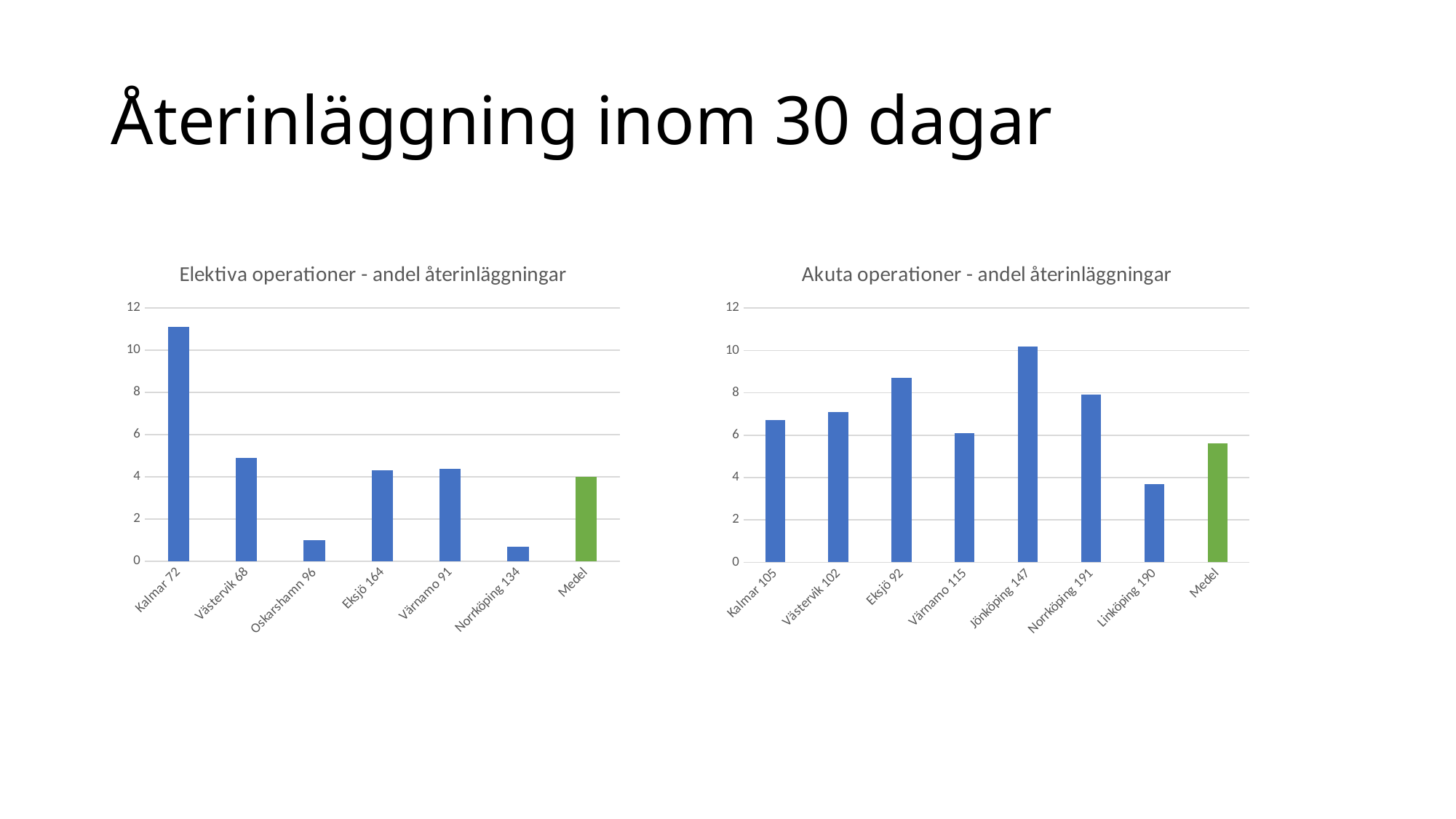
In the chart titled 'Akuta operationer - andel återinläggningar', which category has the lowest bar? Linköping 190 In the chart titled 'Elektiva operationer - andel återinläggningar', which category has the highest bar? Kalmar 72 In the chart titled 'Elektiva operationer - andel återinläggningar', which category has the lowest bar? Norrköping 134 In the chart titled 'Elektiva operationer - andel återinläggningar', which category is shown with a green bar? Medel How many categories are shown in the chart titled 'Elektiva operationer - andel återinläggningar'? 7 In the chart titled 'Elektiva operationer - andel återinläggningar', is the value for Oskarshamn 96 greater or less than 2? less In the chart titled 'Elektiva operationer - andel återinläggningar', is the value for Kalmar 72 greater or less than 10? greater In the chart titled 'Akuta operationer - andel återinläggningar', which category has the highest bar? Jönköping 147 What type of chart is the chart titled 'Akuta operationer - andel återinläggningar'? Bar chart In the chart titled 'Akuta operationer - andel återinläggningar', which is larger, the value for Norrköping 191 or the value for Värnamo 115? Norrköping 191 How many categories are shown in the chart titled 'Akuta operationer - andel återinläggningar'? 8 In the chart titled 'Akuta operationer - andel återinläggningar', is the value for Eksjö 92 greater or less than 8? greater